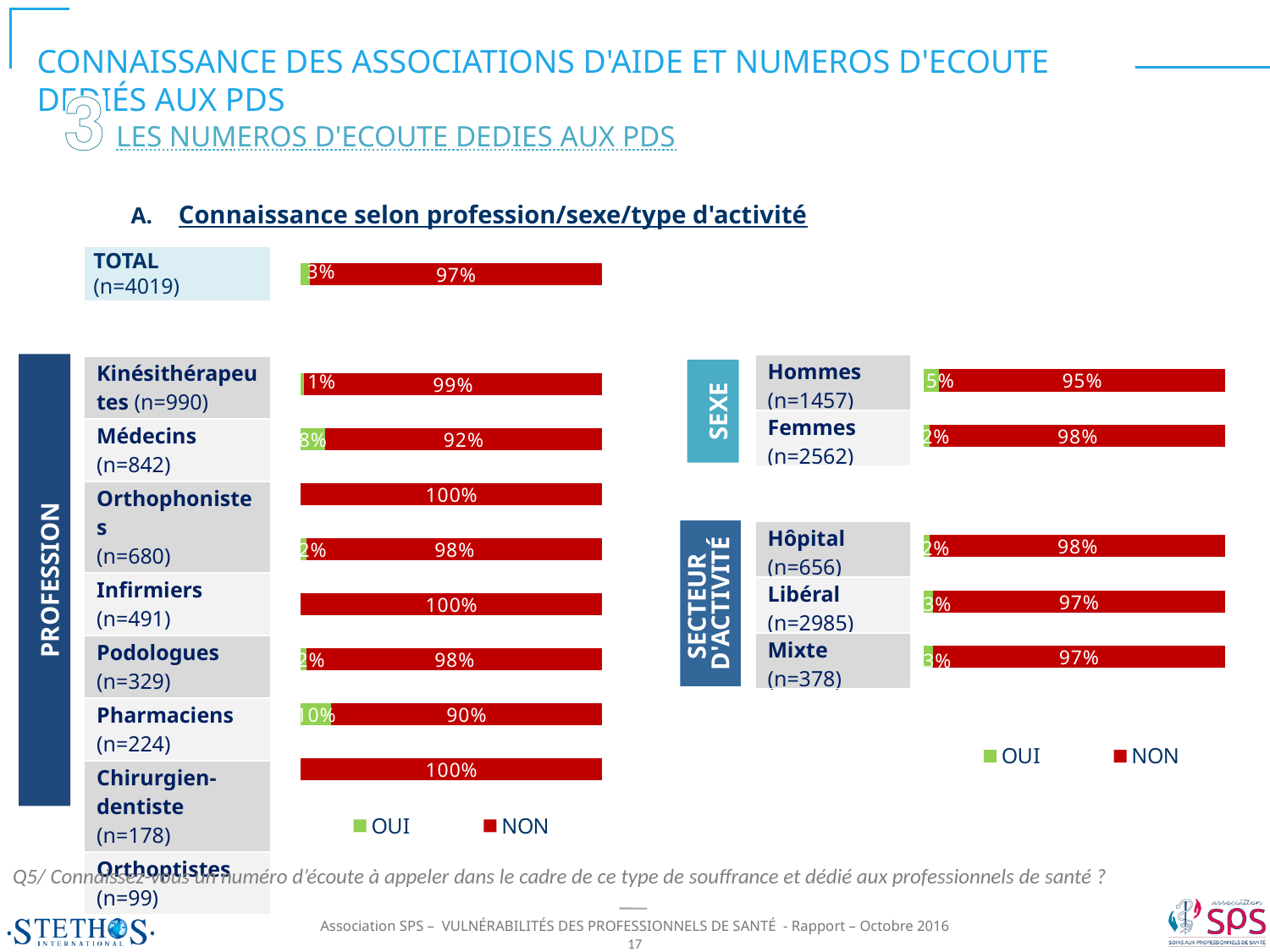
In the SECTEUR D'ACTIVITÉ chart, what is the NON value for Hôpital? 98% In the TOTAL bar at the top of the slide, what percentage answered NON? 97% In the SEXE chart, what is the OUI value for Hommes? 5% In the TOTAL bar at the top of the slide, what percentage answered OUI? 3% How many categories are shown in the SECTEUR D'ACTIVITÉ chart? 3 In the SECTEUR D'ACTIVITÉ chart, what is the OUI value for Libéral? 3% What kind of chart is used in the PROFESSION section? Bar chart In the SEXE chart, what is the NON value for Femmes? 98% In the SEXE chart, which group has the higher OUI share, Hommes or Femmes? Hommes In the PROFESSION chart, what is the NON value for Médecins (n=842)? 92% How many series does the legend of the SECTEUR D'ACTIVITÉ chart list? 2 In the SEXE chart, what is the difference between the OUI values for Hommes and Femmes? 3 percentage points